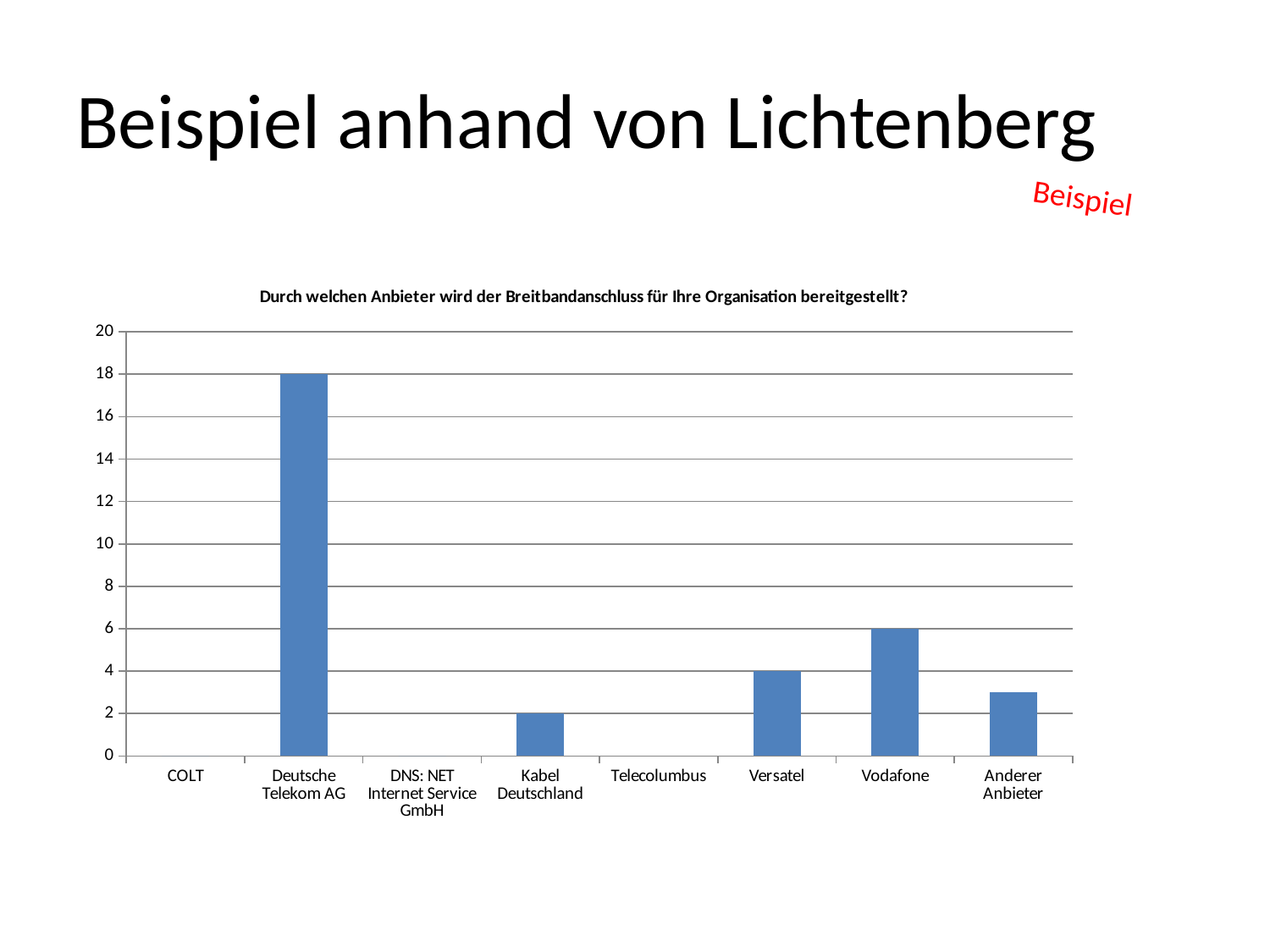
What is the value for Deutsche Telekom AG? 18 Is the value for Anderer Anbieter greater or less than 4? less Which has a larger value, Vodafone or Versatel? Vodafone What is the value for Vodafone? 6 What is the value for Kabel Deutschland? 2 What is the difference between the values for Vodafone and Kabel Deutschland? 4 What kind of chart is shown on the slide? bar chart What is the value for Versatel? 4 What is the title of the chart? Durch welchen Anbieter wird der Breitbandanschluss für Ihre Organisation bereitgestellt? What is the difference between the values for Deutsche Telekom AG and Vodafone? 12 How many provider categories are shown on the x axis of the chart? 8 Which provider has the highest value in the chart? Deutsche Telekom AG